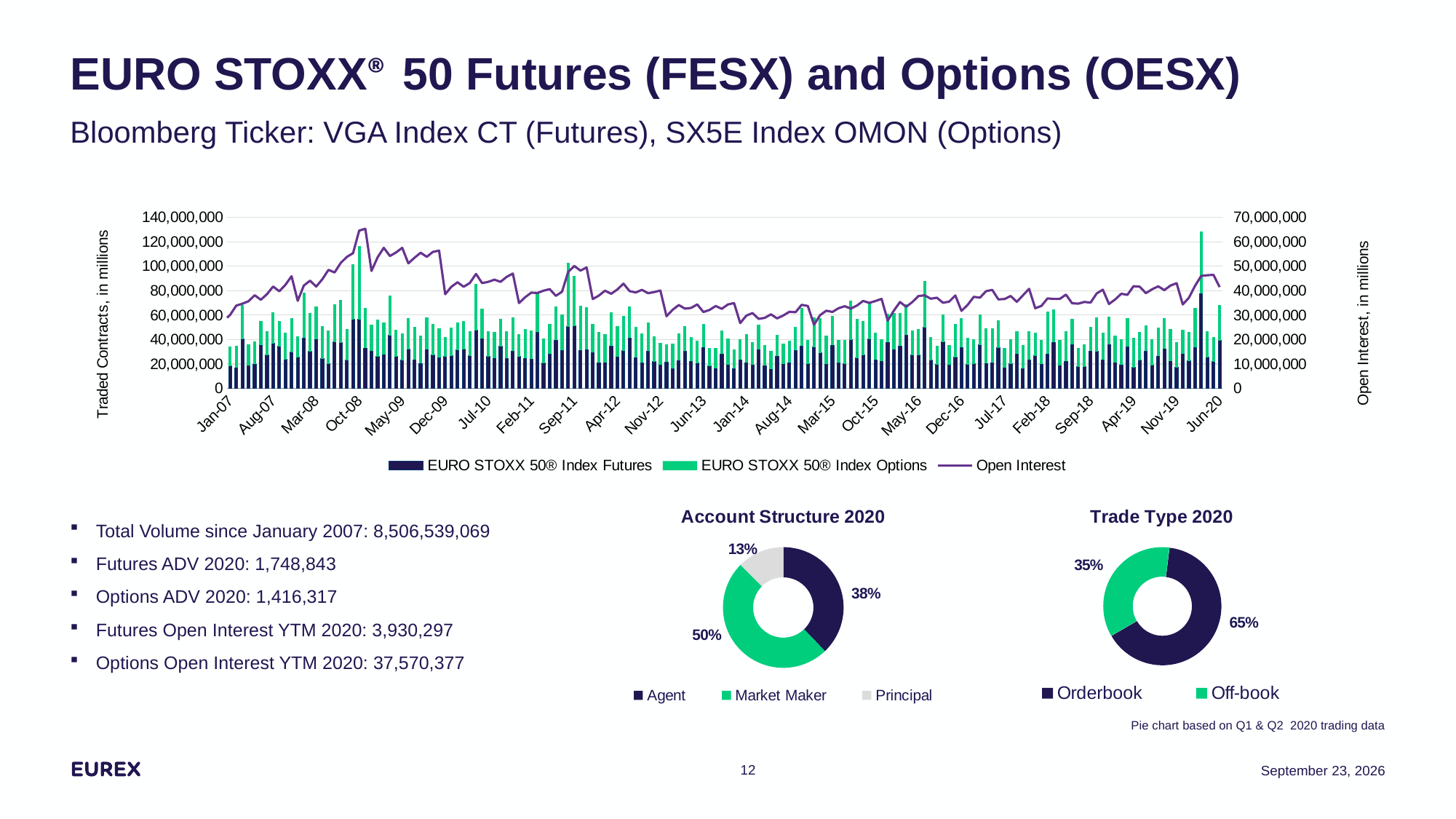
In the Account Structure 2020 chart, which category has the largest share? Market Maker In the Trade Type 2020 chart, which is larger, Orderbook or Off-book? Orderbook In the Account Structure 2020 chart, which category has the smallest share? Principal In the large chart at the top of the slide, how many series does the legend list? 3 In the Account Structure 2020 chart, what share is labelled for Principal? 13% In the Account Structure 2020 chart, how many categories does the legend list? 3 In the Account Structure 2020 chart, what share is labelled for Market Maker? 50% In the Account Structure 2020 chart, how many percentage points larger is Market Maker than Principal? 37 percentage points In the Account Structure 2020 chart, what share is labelled for Agent? 38% In the Trade Type 2020 chart, what share is labelled for Off-book? 35% In the Trade Type 2020 chart, what is the difference between the Orderbook and Off-book shares? 30 percentage points In the Trade Type 2020 chart, what share is labelled for Orderbook? 65%